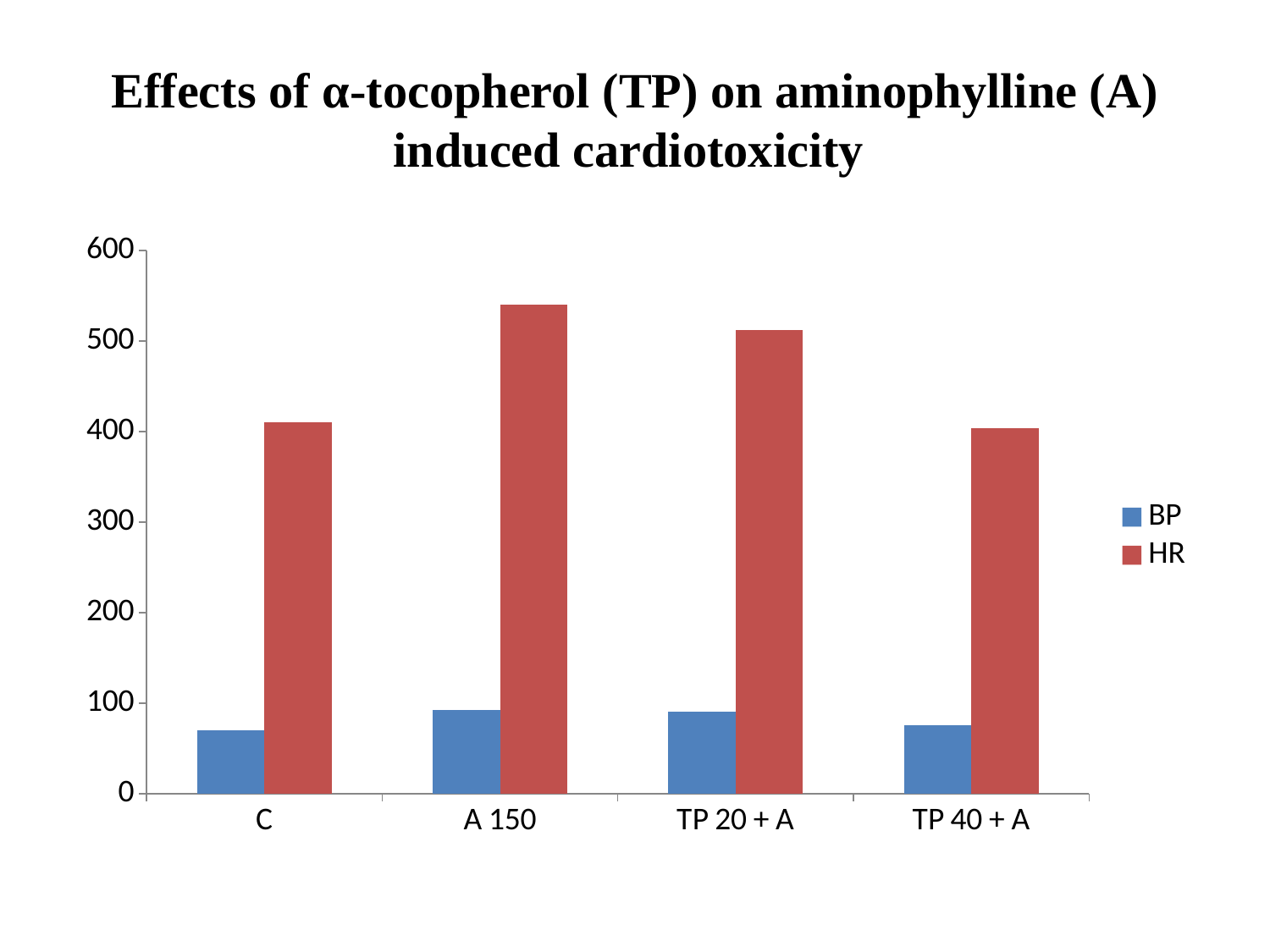
Which is larger, the BP value for C or the BP value for A 150? A 150 Is the HR value for TP 40 + A greater or less than 500? less How many series does the legend list? 2 Which is larger, the HR value for A 150 or the HR value for TP 40 + A? A 150 What kind of chart is shown on the slide? bar chart Which series is shown in red? HR Which category has the highest HR value? A 150 Is the HR value for A 150 greater or less than 500? greater How many categories are shown on the x axis? 4 Is the HR value for C greater or less than 300? greater What is the title of the chart? Effects of α-tocopherol (TP) on aminophylline (A) induced cardiotoxicity